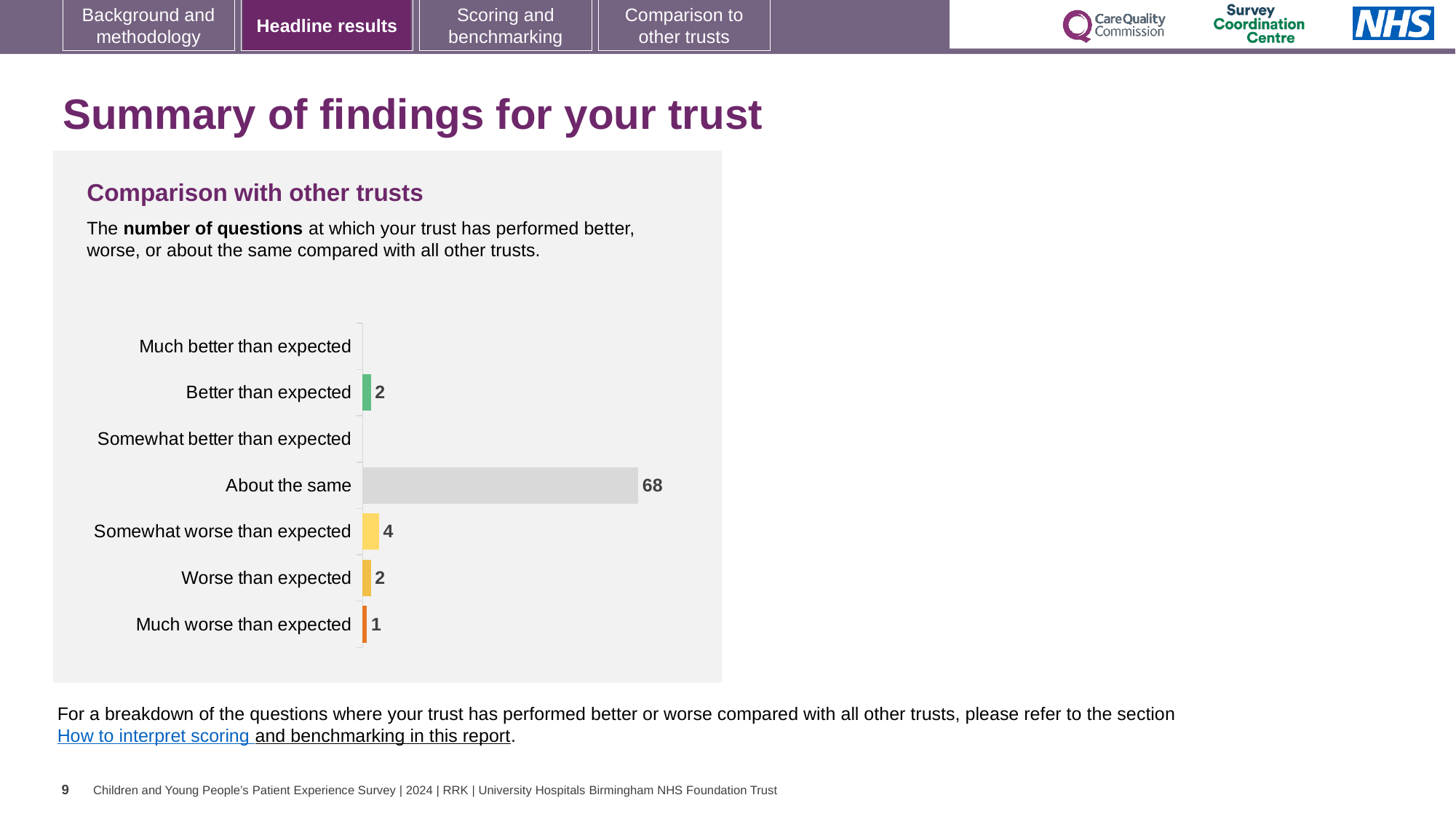
What is the difference between 'About the same' and 'Somewhat worse than expected'? 64 What is the value for 'Better than expected'? 2 What colour is the bar for 'Better than expected'? Green What kind of chart is shown on the slide? Bar chart Which is larger: 'Somewhat worse than expected' or 'Worse than expected'? Somewhat worse than expected How many questions were rated 'About the same'? 68 What is the value for 'Much worse than expected'? 1 What is the title of the chart? Comparison with other trusts What is the value for 'Somewhat worse than expected'? 4 How many categories are listed on the chart's axis? 7 Which category has the highest number of questions? About the same What is the combined number of questions for 'Somewhat worse than expected', 'Worse than expected' and 'Much worse than expected'? 7